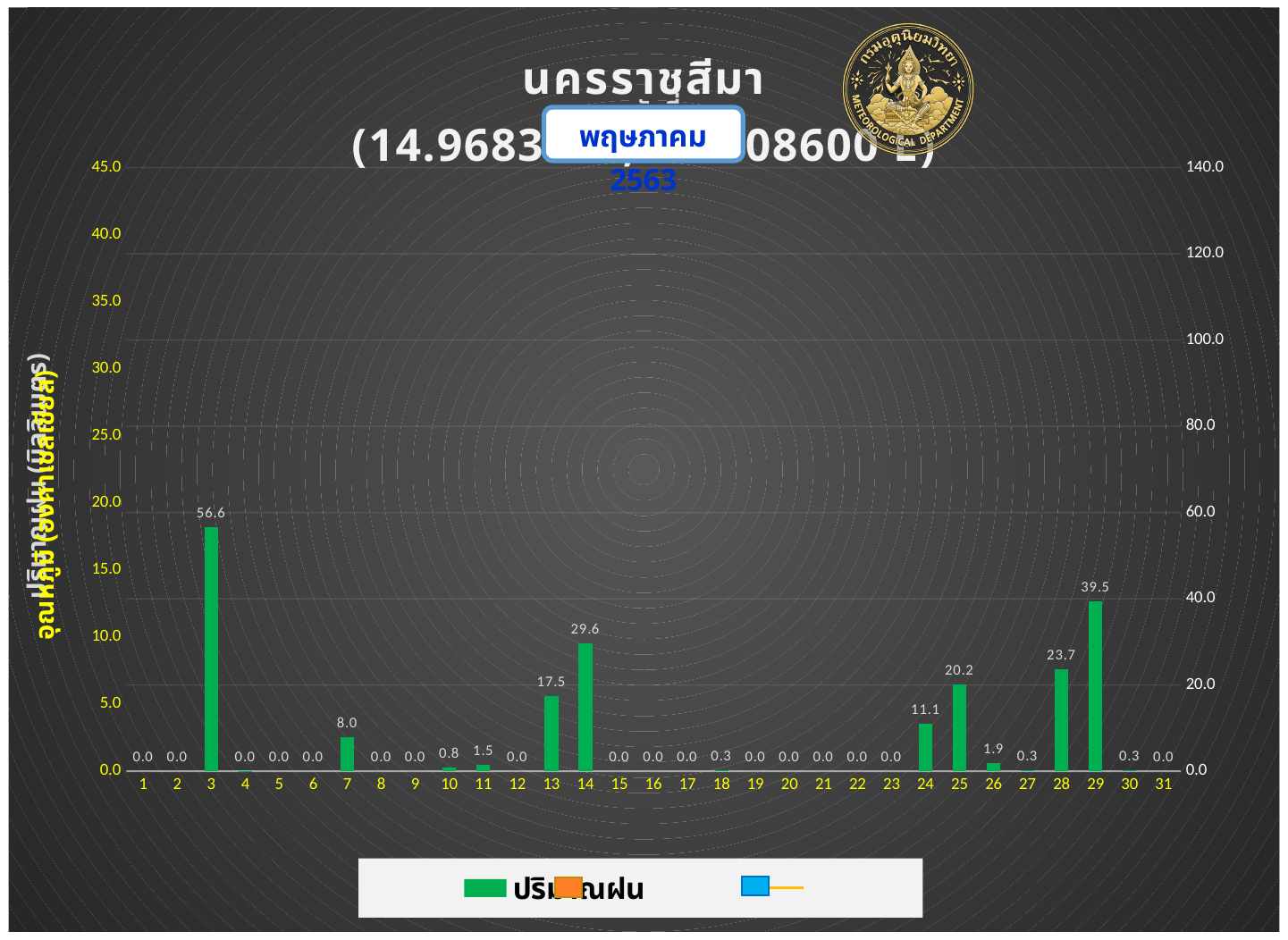
Which day has the highest rainfall value? 3 Which is larger, the rainfall value for day 7 or for day 24? day 24 Which is larger, the rainfall value for day 28 or for day 25? day 28 What is the difference between the rainfall values for day 3 and day 29? 17.1 What is the rainfall value shown for day 3? 56.6 What kind of chart is used to show the rainfall values? bar chart What is the difference between the rainfall values for day 14 and day 13? 12.1 What colour are the bars for ปริมาณฝน in the legend? green What is the rainfall value shown for day 14? 29.6 What is the rainfall value shown for day 25? 20.2 How many days are shown on the x axis? 31 What is the rainfall value shown for day 29? 39.5